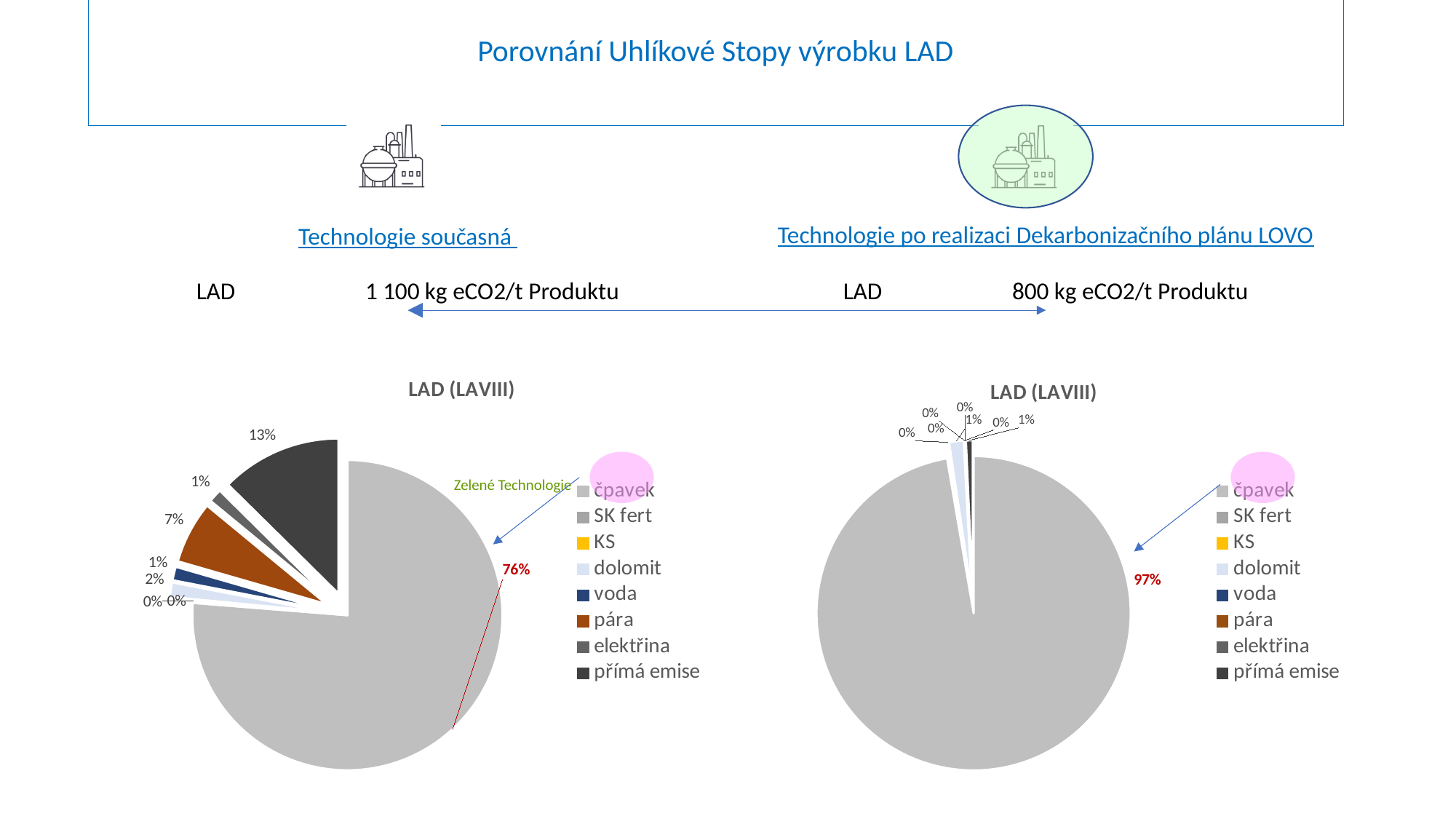
In the left pie chart, what share does dolomit have? 2% Which chart shows a larger share for čpavek, the left one or the right one? the right one How many entries does the legend of the left pie chart list? 8 In the right pie chart (Technologie po realizaci Dekarbonizačního plánu LOVO), what share does čpavek have? 97% In the left pie chart, what share does přímá emise have? 13% In the left pie chart, what is the difference between the přímá emise share and the pára share? 6 percentage points In the left pie chart, which category has the largest slice? čpavek In the left pie chart, which slice is larger, přímá emise or pára? přímá emise In the right pie chart, which category has the largest slice? čpavek By how many percentage points does the čpavek share in the right pie chart exceed the čpavek share in the left pie chart? 21 percentage points